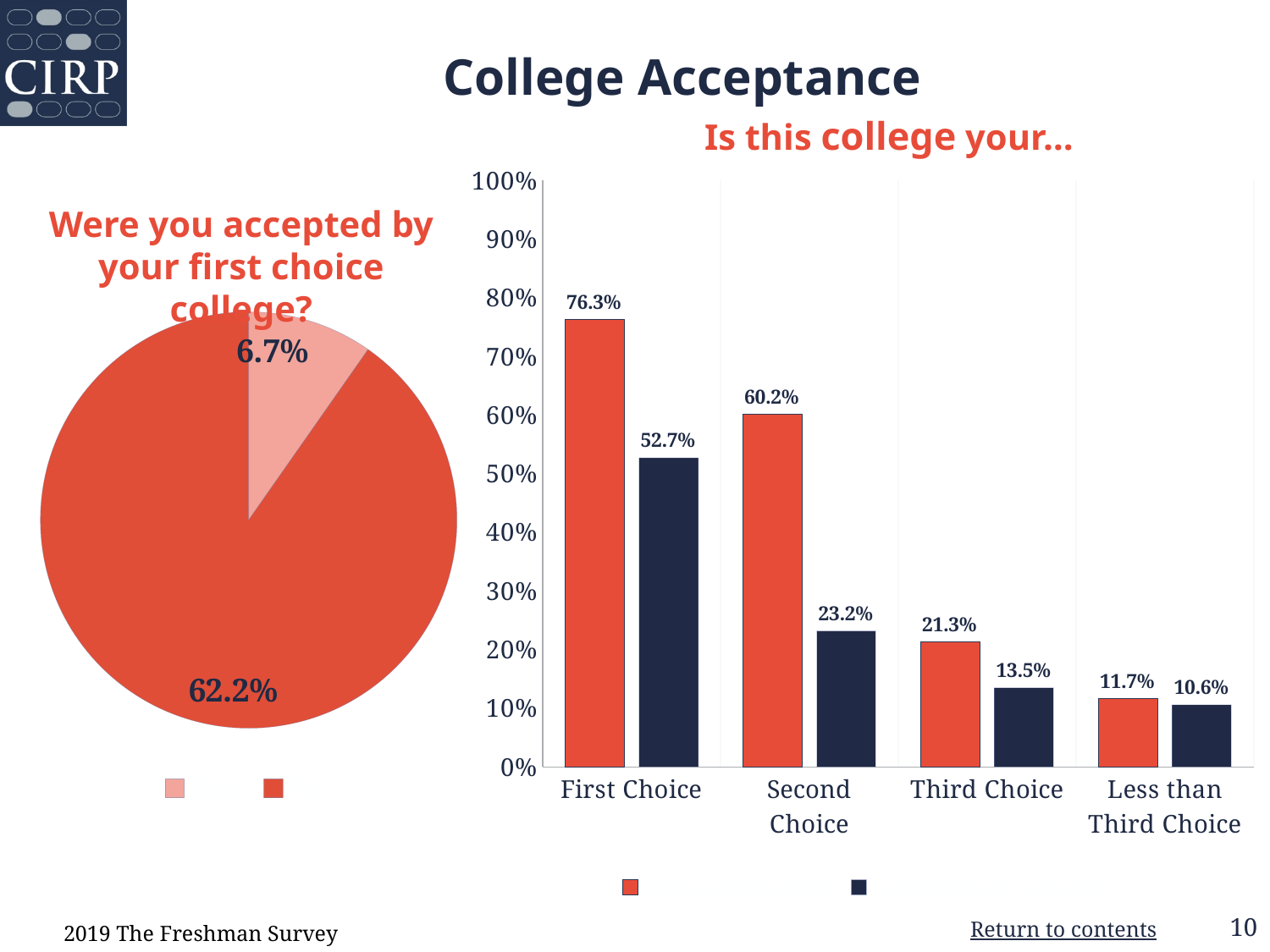
In the bar chart 'Is this college your...', which category has the lowest dark navy bar? Less than Third Choice In the bar chart 'Is this college your...', which is larger for Third Choice, the orange bar or the dark navy bar? The orange bar (21.3%) How many categories are shown on the x axis of the bar chart 'Is this college your...'? 4 In the bar chart 'Is this college your...', what is the value of the orange bar for Less than Third Choice? 11.7% What kind of chart is 'Is this college your...'? Bar chart In the bar chart 'Is this college your...', what is the value of the dark navy bar for Second Choice? 23.2% In the bar chart 'Is this college your...', what is the value of the orange bar for First Choice? 76.3% In the pie chart 'Were you accepted by your first choice college?', what is the value of the larger slice? 62.2% In the bar chart 'Is this college your...', do the orange bars rise or fall from First Choice to Less than Third Choice? Fall How many series does the legend of the bar chart 'Is this college your...' show? 2 In the bar chart 'Is this college your...', what is the difference between the orange and dark navy bars for First Choice? 23.6 percentage points In the bar chart 'Is this college your...', which category has the highest orange bar? First Choice